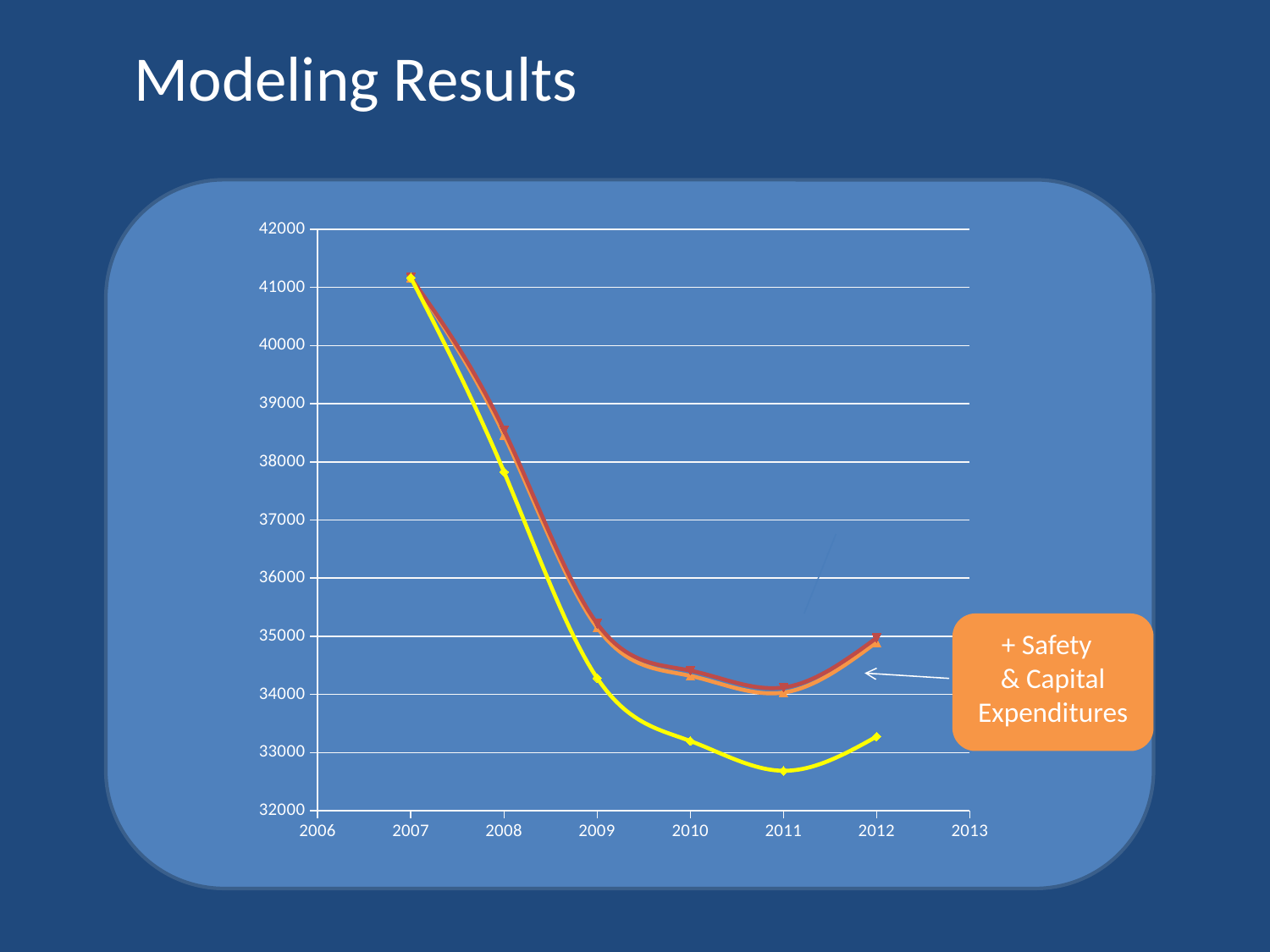
What does the orange callout box on the chart say? + Safety & Capital Expenditures What kind of chart is shown on the slide? line chart In which year does the yellow line reach its highest value? 2007 Is the value of the red line in 2009 greater or less than 35000? greater Is the value of the yellow line in 2011 greater or less than 33000? less Do the values of the yellow line rise or fall from 2007 to 2011? fall In which year does the yellow line reach its lowest value? 2011 In 2011, which line has the higher value, the yellow line or the red line? the red line How many data points does the yellow line have? 6 Is the value of the red line in 2008 greater or less than 38000? greater How many lines are plotted on the chart? 3